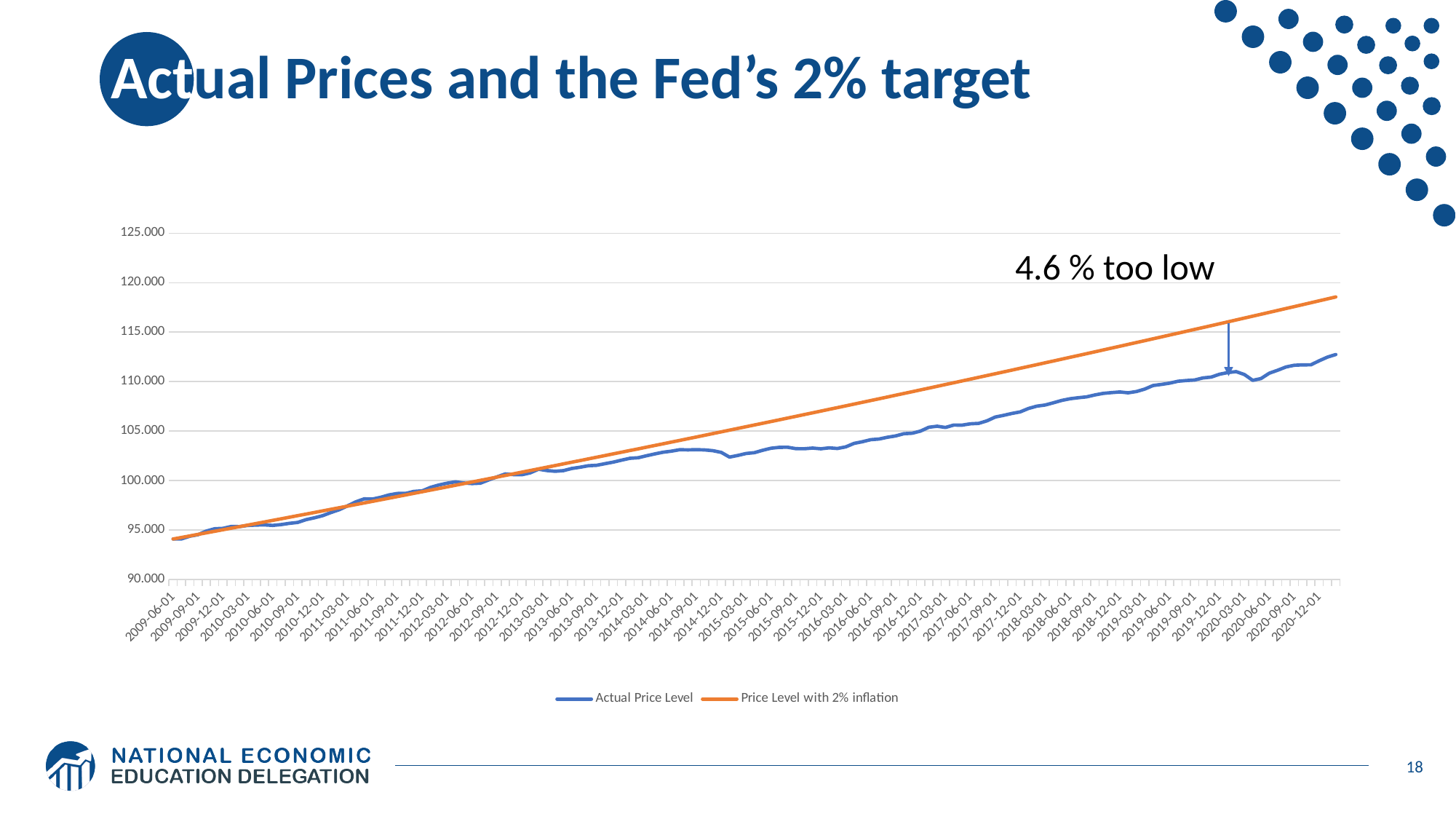
What does the annotation above the right end of the chart say? 4.6 % too low Does the Actual Price Level rise or fall from 2009-06-01 to 2020-12-01? rise Does the Price Level with 2% inflation line rise or fall along the x axis? rise Is the Price Level with 2% inflation at 2017-03-01 greater or less than 105.000? greater Is the Actual Price Level at 2015-03-01 greater or less than 105.000? less Is the Actual Price Level at 2020-12-01 greater or less than 110.000? greater At 2020-12-01, which series is higher: Actual Price Level or Price Level with 2% inflation? Price Level with 2% inflation What kind of chart is shown on the slide? line chart What are the two series named in the legend? Actual Price Level; Price Level with 2% inflation How many series does the legend list? 2